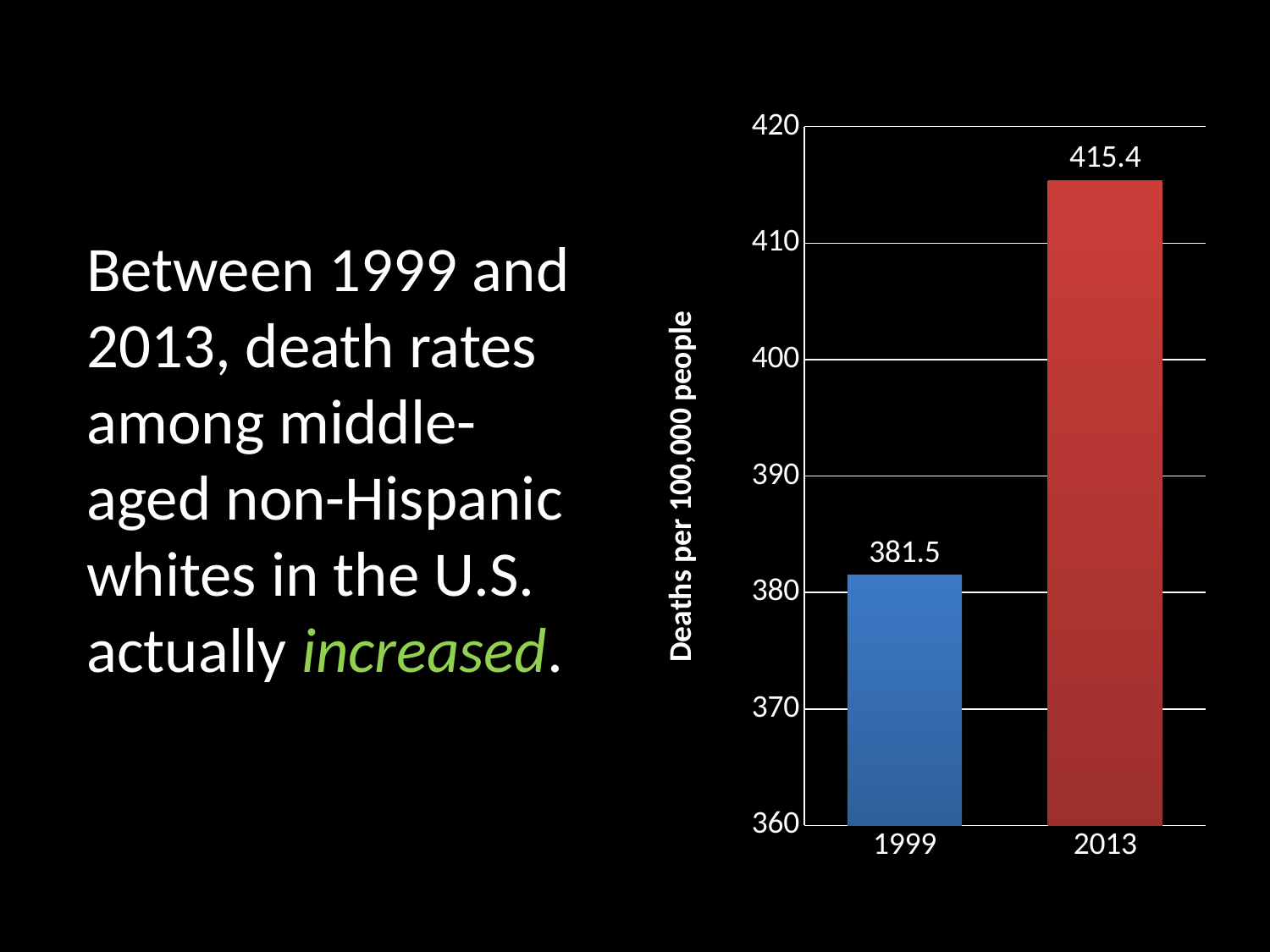
What is the value for 1999? 381.5 What kind of chart is shown on the slide? Bar chart What is the label on the vertical axis of the chart? Deaths per 100,000 people Which year has the higher death rate? 2013 Do the values rise or fall from 1999 to 2013? Rise Is the value for 2013 greater or less than 410? greater How many bars are shown in the chart? 2 What is the value for 2013? 415.4 Is the value for 1999 greater or less than 390? less What is the difference between the 2013 value and the 1999 value? 33.9 Which year has the lower death rate? 1999 Is the value for 2013 larger than the value for 1999? Yes